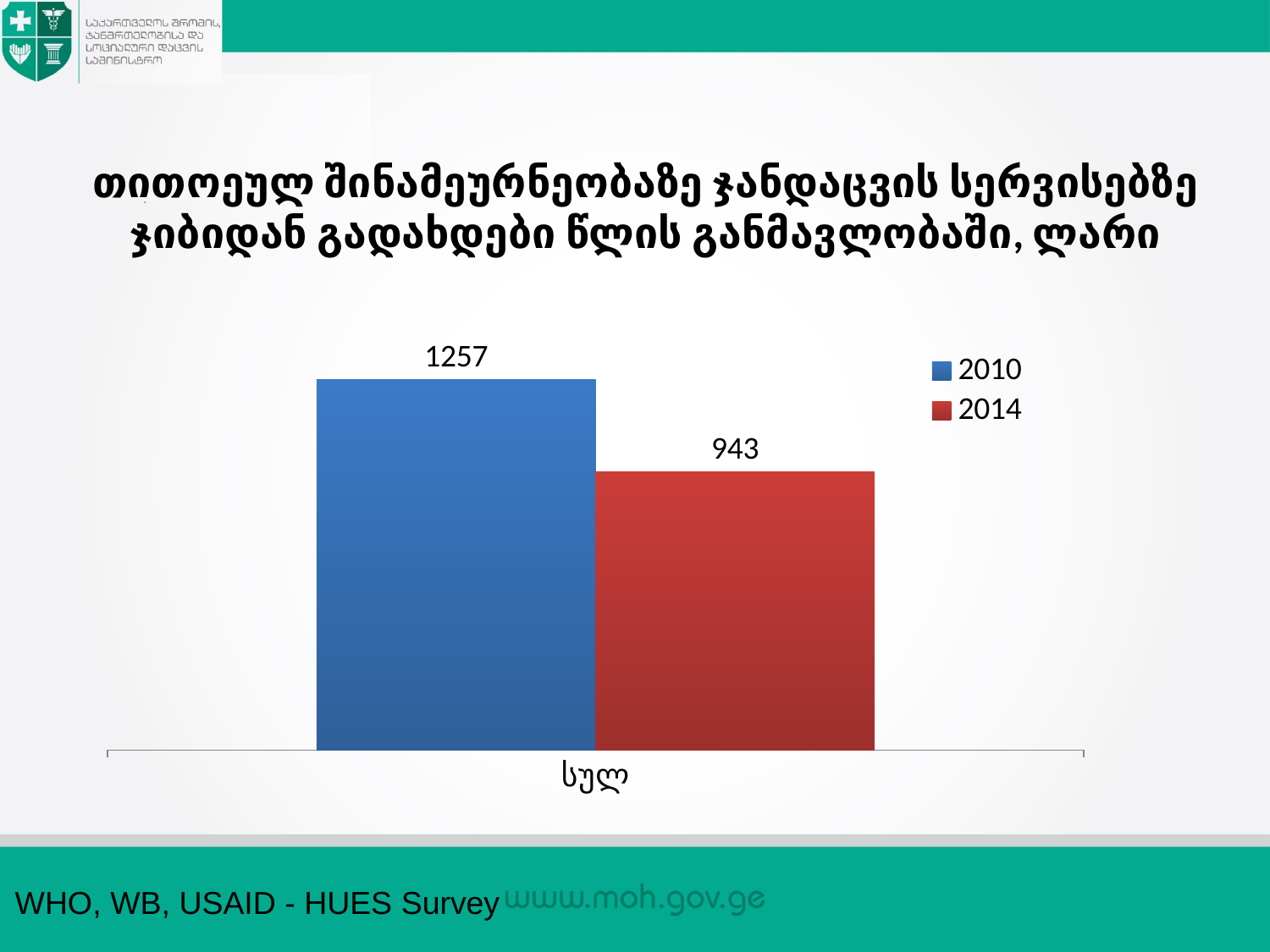
What is the value for 2010 in the chart? 1257 Which series has the highest value in the chart? 2010 What kind of chart is shown on the slide? bar chart Which series has the lowest value in the chart? 2014 How many series does the legend list? 2 What is the difference between the 2010 value and the 2014 value? 314 Did the value fall or rise from 2010 to 2014? fall What is the category label on the x axis? სულ How many categories are shown on the x axis? 1 Which colour represents the 2014 series in the legend? red Which year has the higher value, 2010 or 2014? 2010 What is the value for 2014 in the chart? 943